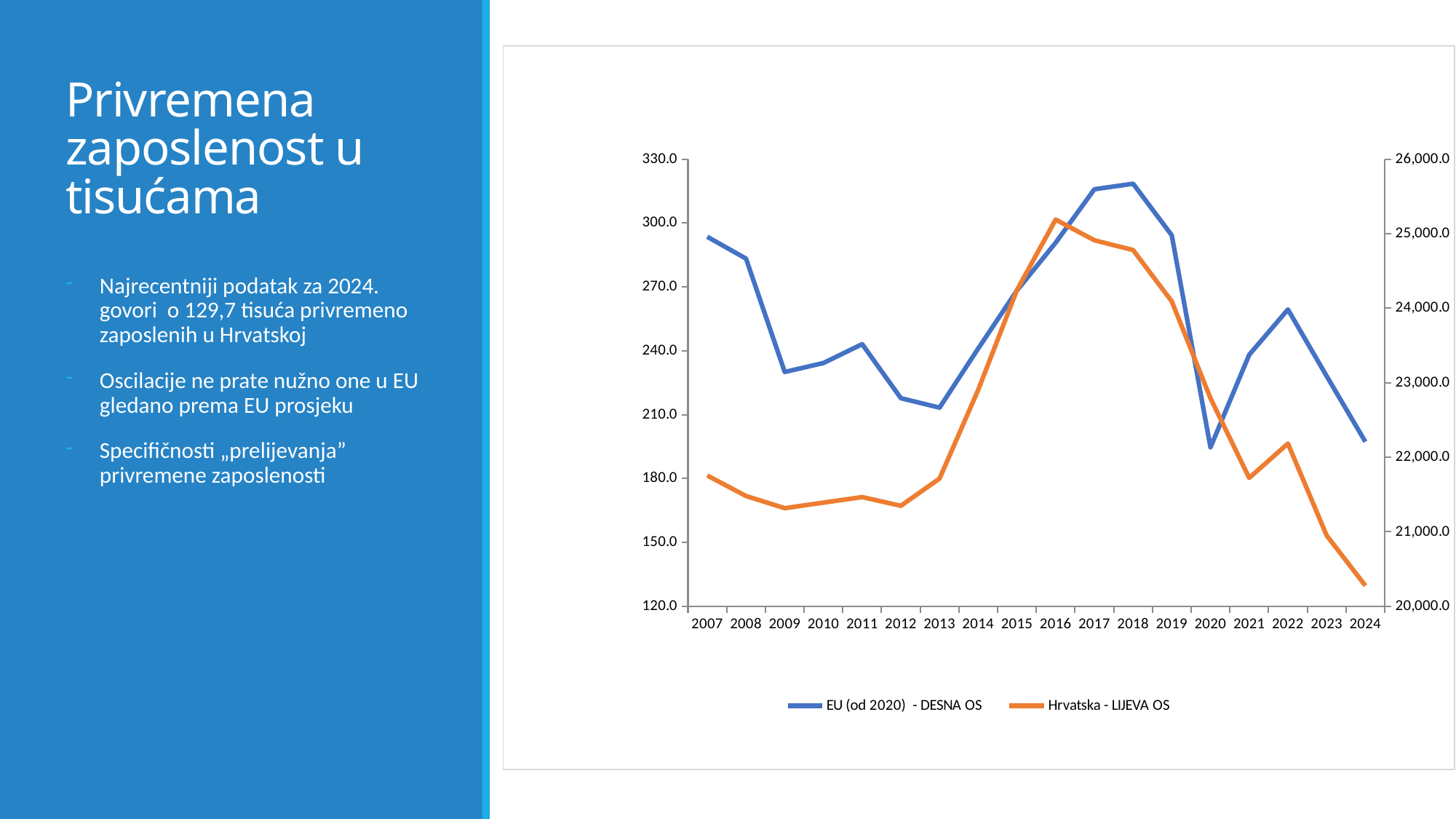
Which axis does the Hrvatska series use according to the legend? left axis (LIJEVA OS) Is the value for EU (od 2020) - DESNA OS in 2020 greater or less than 23,000.0? less How many series does the legend list? 2 Is the value for Hrvatska - LIJEVA OS in 2016 greater or less than 270.0? greater Does the Hrvatska - LIJEVA OS series rise or fall from 2022 to 2024? fall In which year does the Hrvatska - LIJEVA OS series reach its highest value? 2016 Is the value for EU (od 2020) - DESNA OS in 2017 greater or less than 25,000.0? greater How many years are shown on the x axis? 18 In which year does the Hrvatska - LIJEVA OS series reach its lowest value? 2024 Which is larger for Hrvatska - LIJEVA OS: the value in 2016 or the value in 2007? 2016 What kind of chart is shown on the slide? line chart